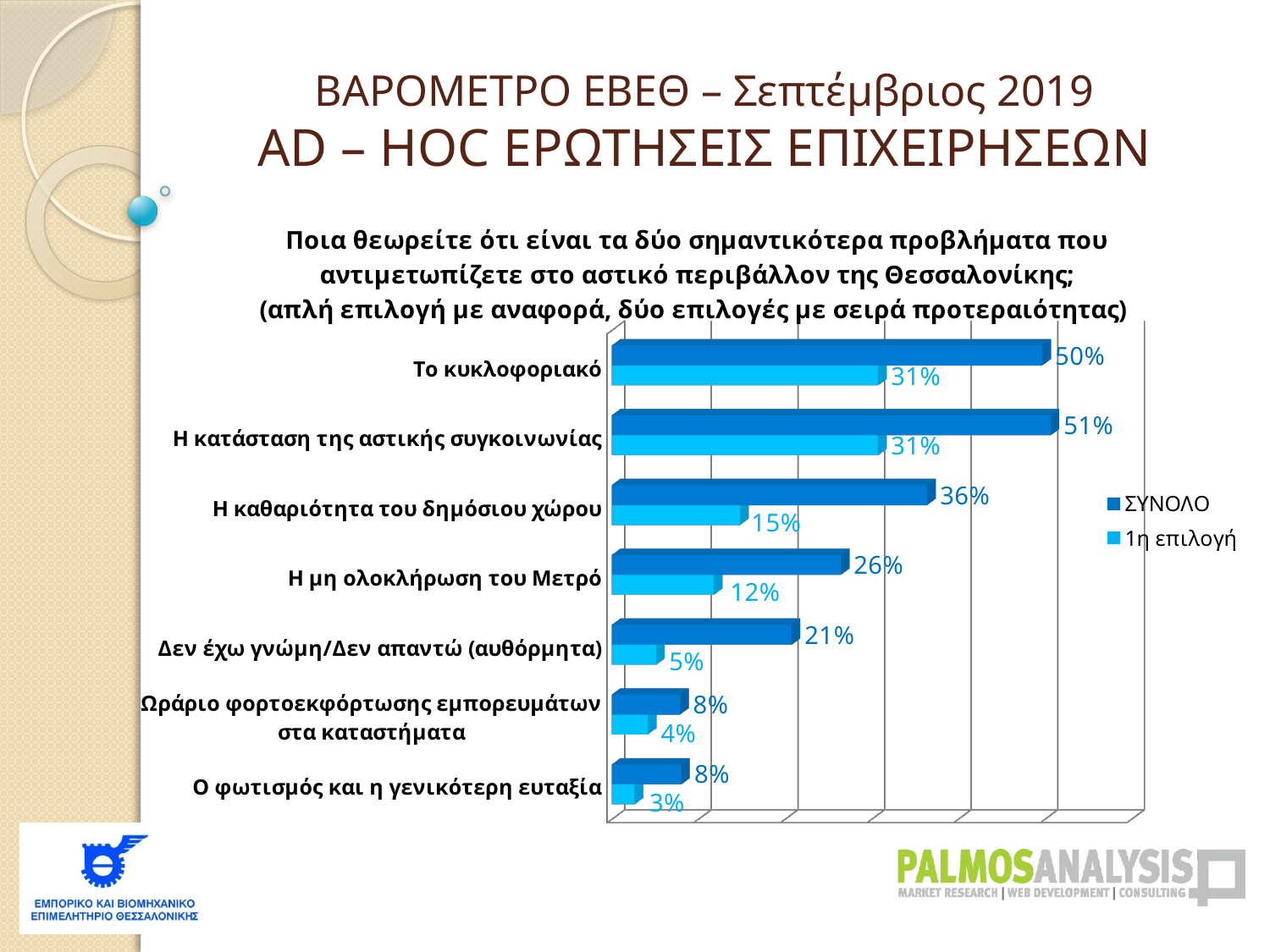
Which is larger: the 1η επιλογή value for Η μη ολοκλήρωση του Μετρό or the 1η επιλογή value for Δεν έχω γνώμη/Δεν απαντώ (αυθόρμητα)? Η μη ολοκλήρωση του Μετρό Which category has the lowest 1η επιλογή value? Ο φωτισμός και η γενικότερη ευταξία Which category has the highest ΣΥΝΟΛΟ value? Η κατάσταση της αστικής συγκοινωνίας What is the 1η επιλογή value for Ωράριο φορτοεκφόρτωσης εμπορευμάτων στα καταστήματα? 4% What is the ΣΥΝΟΛΟ value for Το κυκλοφοριακό? 50% How many categories are shown in the chart? 7 How many series does the legend list? 2 What is the difference between the ΣΥΝΟΛΟ and 1η επιλογή values for Η κατάσταση της αστικής συγκοινωνίας? 20% What is the 1η επιλογή value for Η καθαριότητα του δημόσιου χώρου? 15% Which legend entry is shown in dark blue? ΣΥΝΟΛΟ What is the ΣΥΝΟΛΟ value for Η μη ολοκλήρωση του Μετρό? 26% What type of chart is shown on the slide? Bar chart